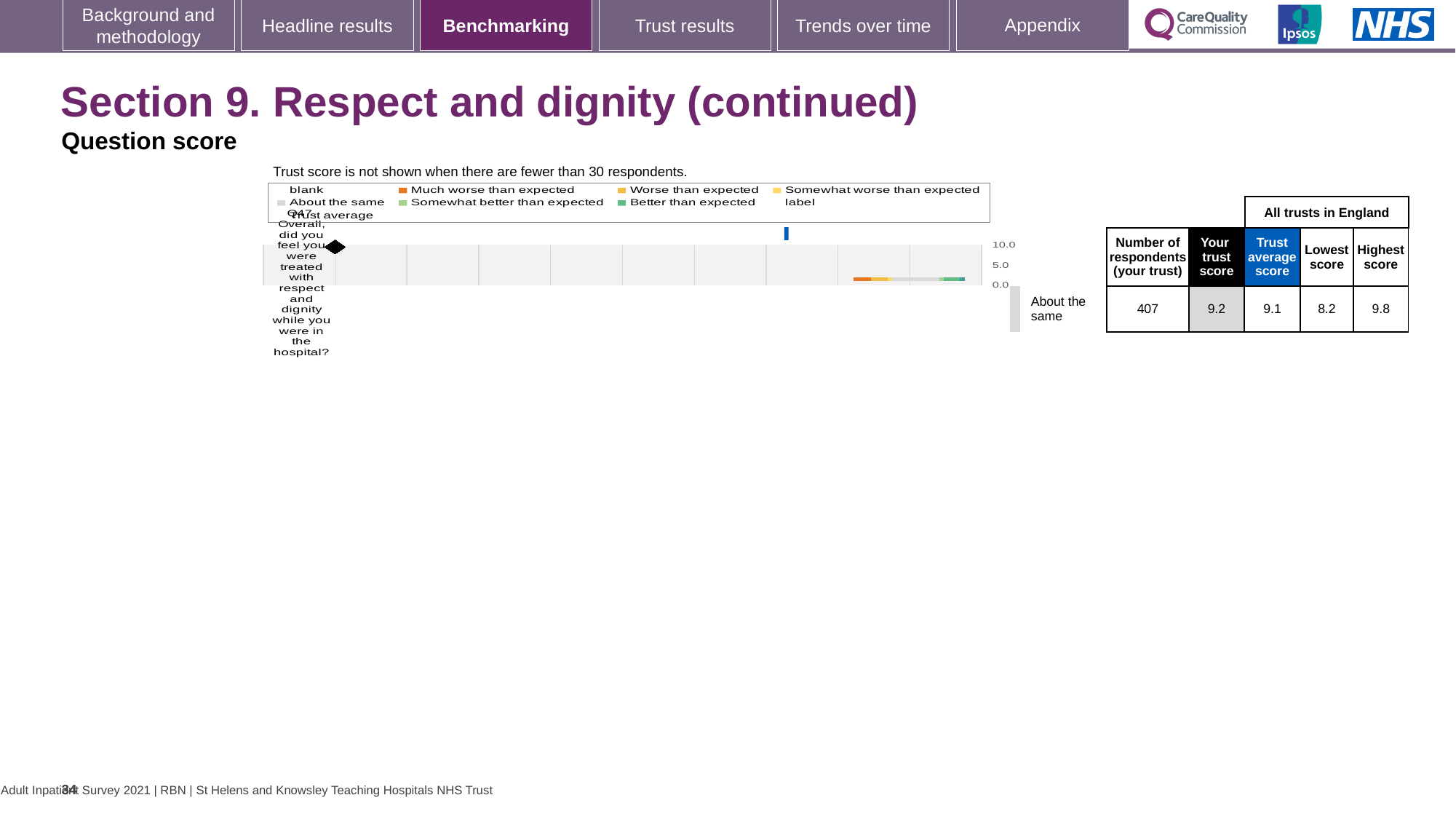
What is the highest value shown on the chart's score axis? 10.0 What is the trust score for Q47 shown in the table next to the chart? 9.2 What is the difference between the highest score and the lowest score for Q47? 1.6 Which is larger for Q47, your trust score or the trust average score? Your trust score How many questions are plotted on the chart? 1 What is the highest score across all trusts in England for Q47? 9.8 How is your trust's result for Q47 categorised relative to expectations? About the same What is the lowest score across all trusts in England for Q47? 8.2 What colour does the legend use for 'Much worse than expected'? Orange How many respondents from your trust answered Q47? 407 What is the difference between your trust score and the trust average score for Q47? 0.1 What is the trust average score for Q47 shown in the table? 9.1